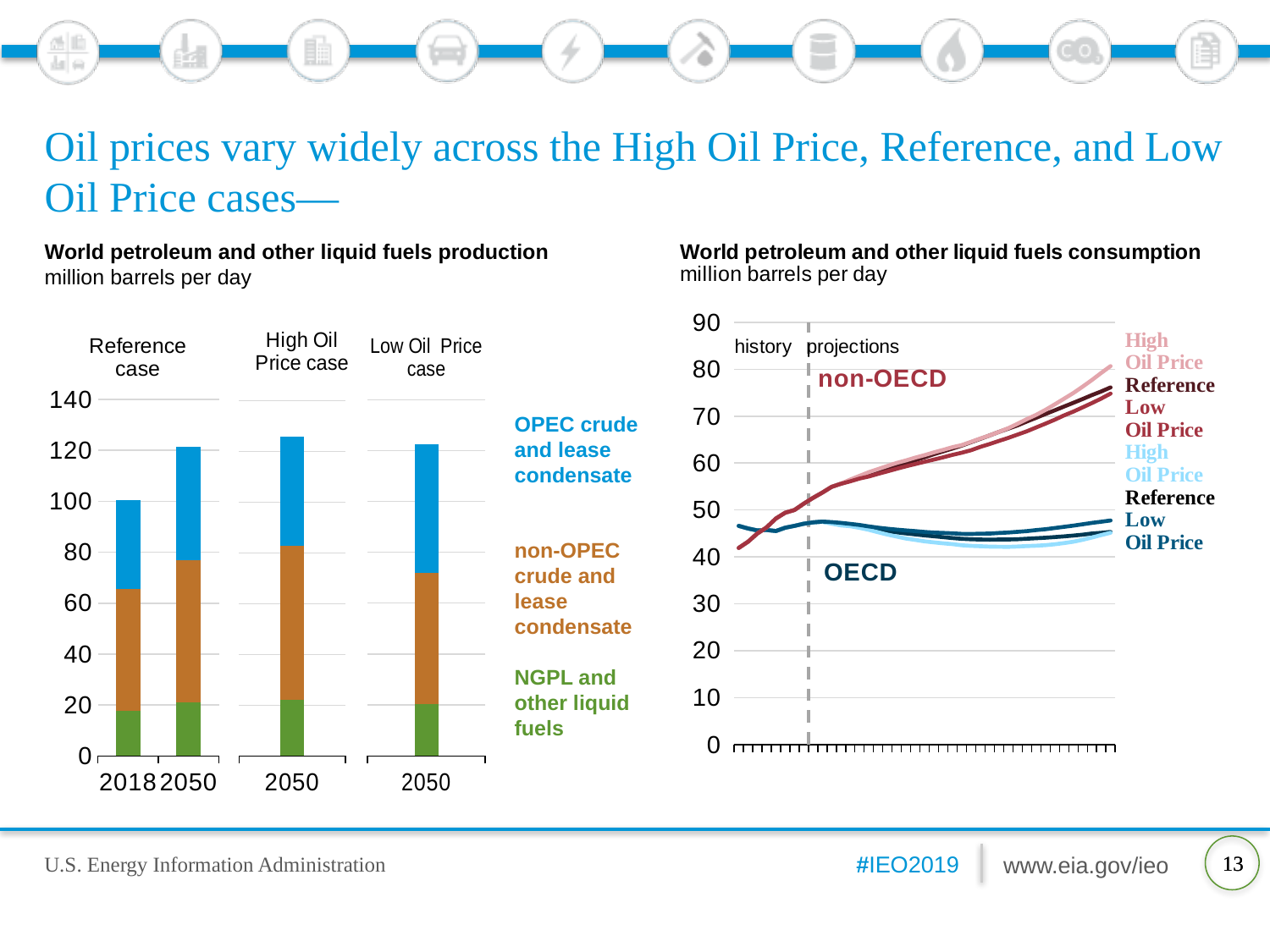
In the production chart on the left, how many series does the legend list? 3 In the consumption chart on the right, at the end of the projection period, which is larger: non-OECD consumption or OECD consumption? non-OECD In the production chart on the left, which series is shown in green? NGPL and other liquid fuels In the production chart on the left, is the total for the 2050 High Oil Price case bar greater or less than 120? greater In the consumption chart on the right, do the non-OECD lines rise or fall over the projection period? rise In the production chart on the left, how many bars are plotted? 4 In the consumption chart on the right, is the OECD Reference value at the end of the projection period greater or less than 50? less What type of chart is the 'World petroleum and other liquid fuels consumption' chart on the right? line chart In the production chart on the left, is the total for the 2018 Reference case bar greater or less than 120? less In the consumption chart on the right, what unit is given below the chart title? million barrels per day What type of chart is the 'World petroleum and other liquid fuels production' chart on the left? bar chart In the production chart on the left, which bar has the lowest total? 2018 Reference case